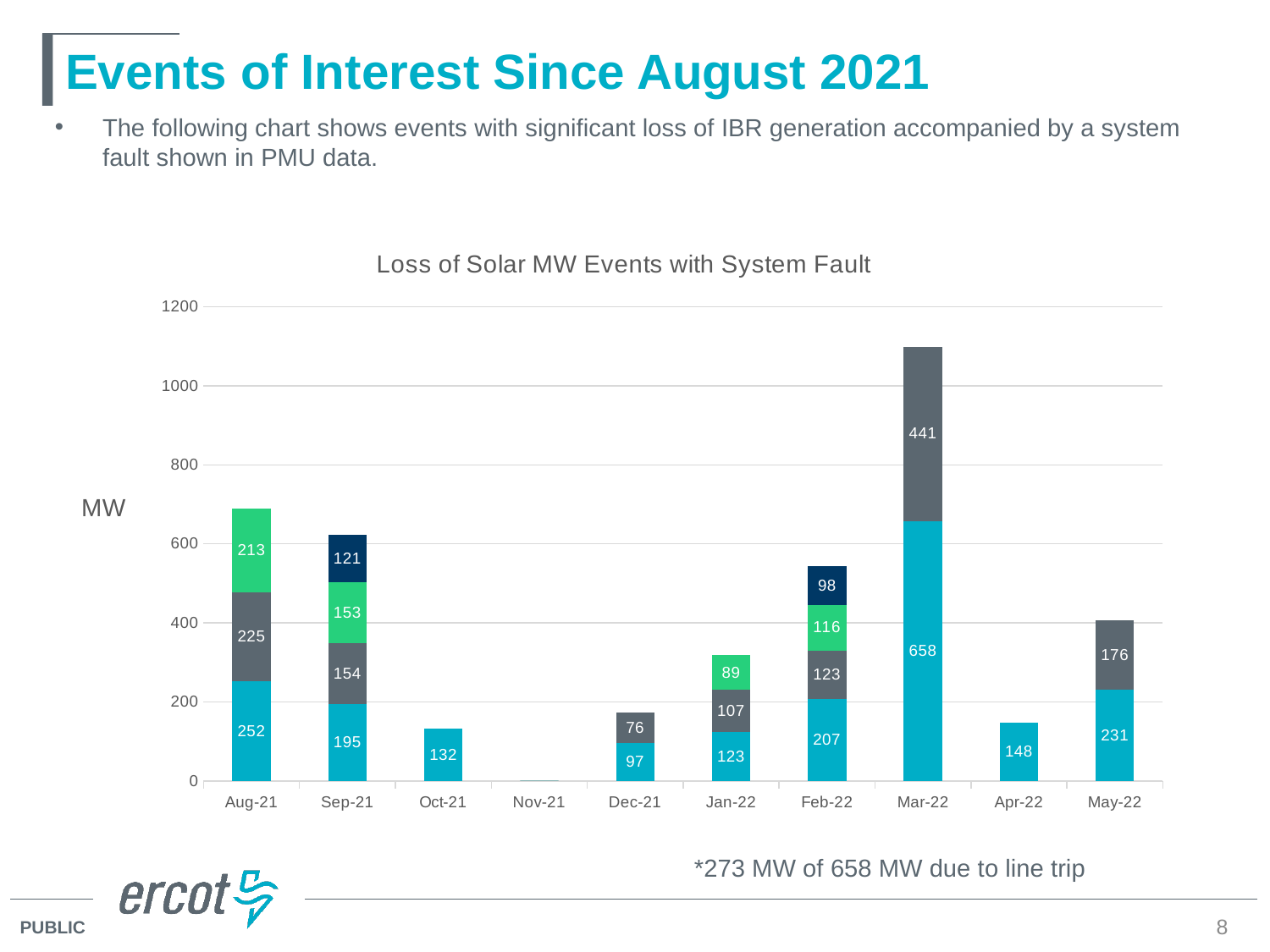
Is the total for Mar-22 greater or less than 1000? greater What is the total of the Sep-21 stacked bar? 623 What is the difference between the bottom segment (658) and the top segment (441) of the Mar-22 bar? 217 What is the total of the Aug-21 stacked bar? 690 What is the total of the Mar-22 stacked bar? 1099 What is the value of the top segment of the Mar-22 bar? 441 Which is larger, the value for Oct-21 or the value for Apr-22? Apr-22 What is the title of the chart? Loss of Solar MW Events with System Fault Which month has the highest total loss of solar MW? Mar-22 What kind of chart is shown on the slide? Stacked bar chart What is the value of the bottom segment of the Mar-22 bar? 658 How many months are shown on the x axis of the chart? 10